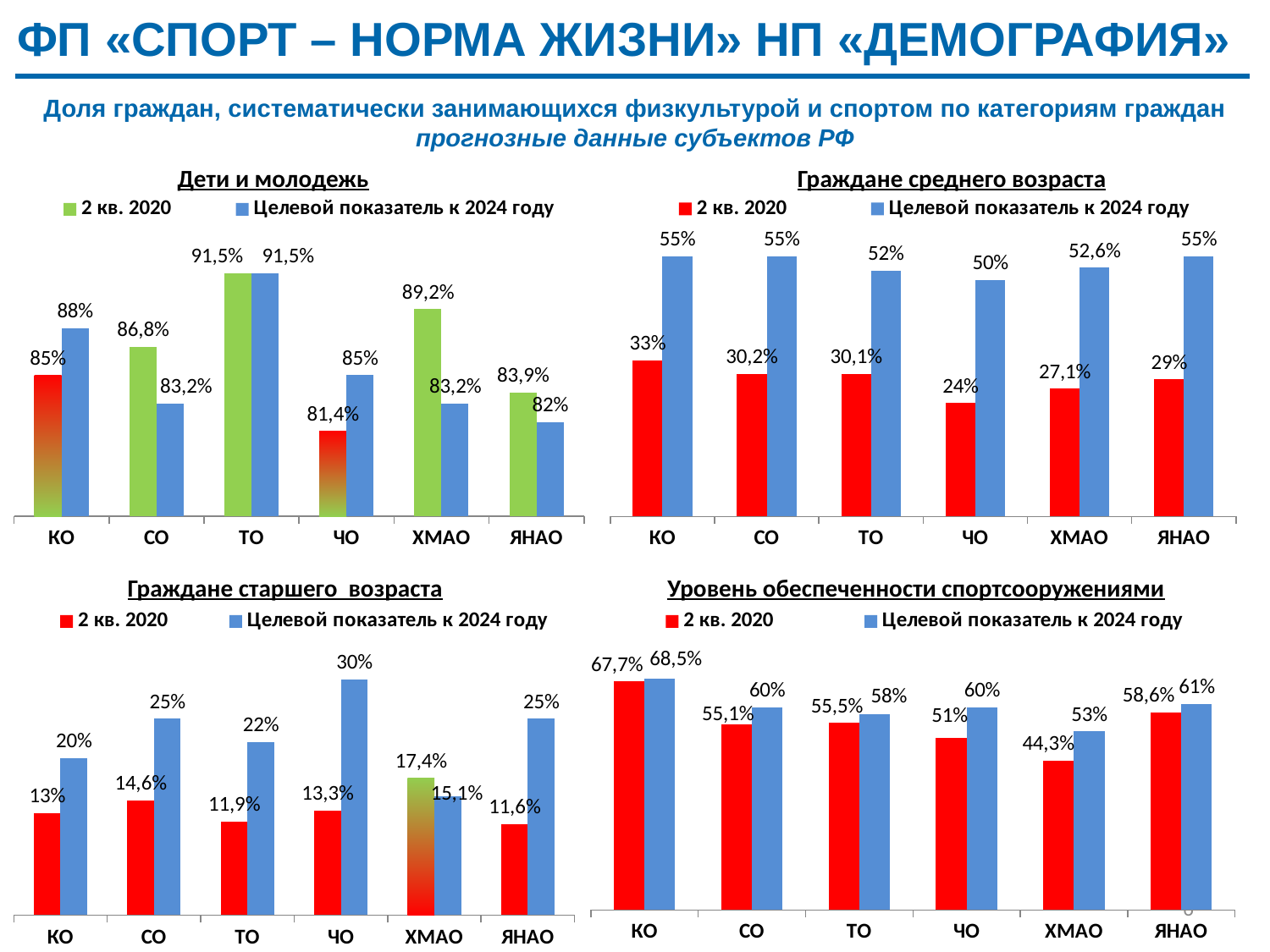
In the chart «Граждане среднего возраста», what is the difference between the «Целевой показатель к 2024 году» and «2 кв. 2020» values for КО? 22% In the chart «Уровень обеспеченности спортсооружениями», which category has the highest value in the series «2 кв. 2020»? КО How many series does the legend of the chart «Дети и молодежь» list? 2 In the chart «Граждане среднего возраста», which category has the lowest value in the series «2 кв. 2020»? ЧО In the chart «Граждане старшего возраста», what is the value for ХМАО in the series «2 кв. 2020»? 17,4% In the chart «Дети и молодежь», what is the value for ТО in the series «2 кв. 2020»? 91,5% How many categories are shown on the x axis of the chart «Уровень обеспеченности спортсооружениями»? 6 In the chart «Граждане старшего возраста», which category has the highest value in the series «Целевой показатель к 2024 году»? ЧО In the chart «Уровень обеспеченности спортсооружениями», what is the value for ХМАО in the series «2 кв. 2020»? 44,3% In the chart «Граждане среднего возраста», what is the value for ХМАО in the series «Целевой показатель к 2024 году»? 52,6% In the chart «Граждане старшего возраста», which is larger for ХМАО: the «2 кв. 2020» value or the «Целевой показатель к 2024 году» value? 2 кв. 2020 In the chart «Дети и молодежь», which category has the lowest value in the series «2 кв. 2020»? ЧО